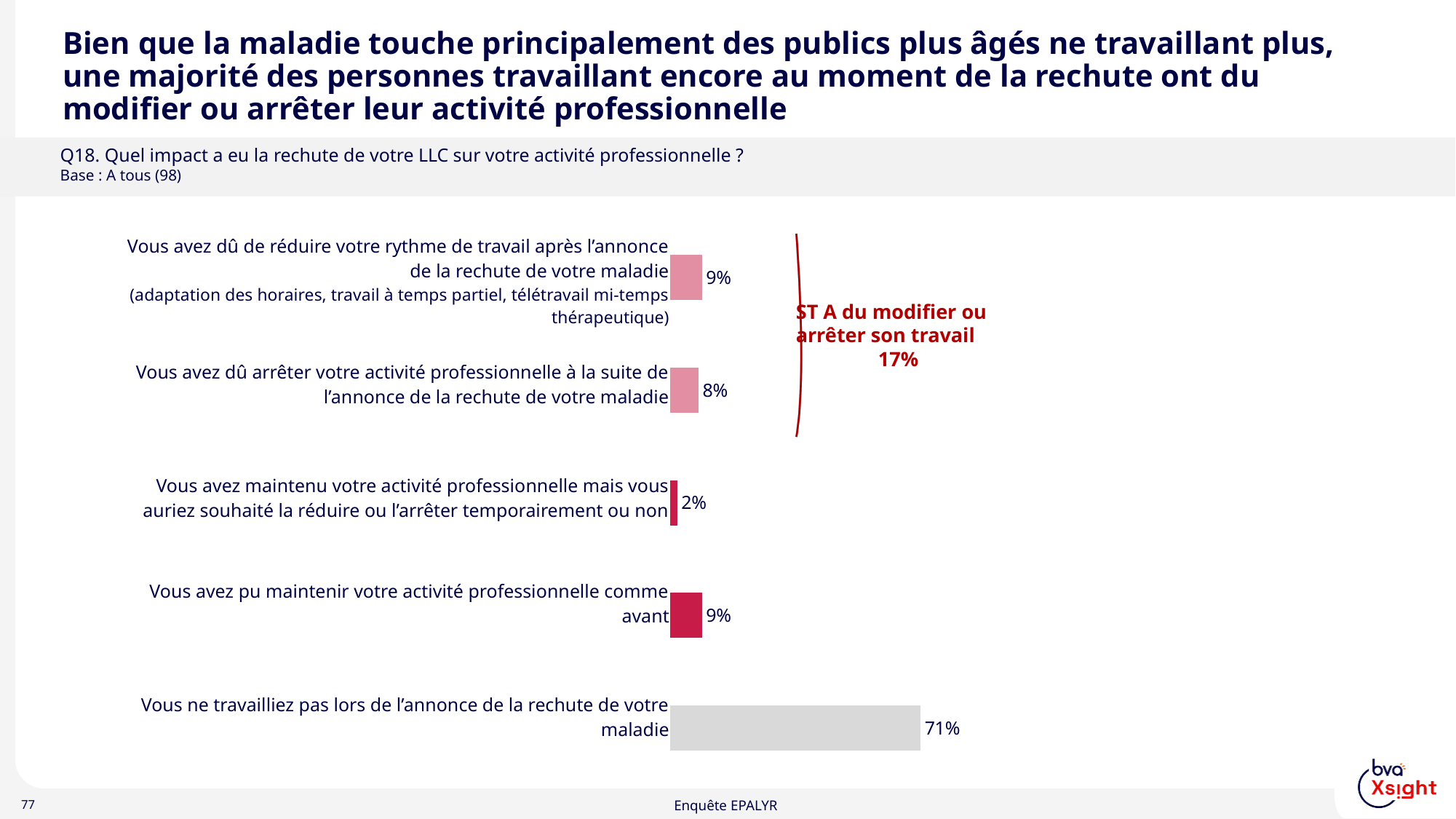
What percentage had to stop their professional activity following the relapse announcement? 8% How many categories are shown in the chart? 5 What percentage maintained their professional activity but would have liked to reduce or stop it temporarily or not? 2% What is the difference between the share who did not work at the time of the relapse (71%) and the share who were able to maintain their activity as before (9%)? 62 percentage points Which category has the lowest value? Vous avez maintenu votre activité professionnelle mais vous auriez souhaité la réduire ou l'arrêter temporairement ou non Which is larger: the share who had to reduce their work rhythm or the share who had to stop their professional activity? The share who had to reduce their work rhythm (9%) Which category has the highest value? Vous ne travailliez pas lors de l'annonce de la rechute de votre maladie What percentage were able to maintain their professional activity as before? 9% What type of chart is shown on the slide? Bar chart What percentage had to reduce their work rhythm after the relapse announcement? 9% What percentage of respondents did not work at the time of the relapse announcement ("Vous ne travailliez pas lors de l'annonce de la rechute de votre maladie")? 71% What is the value of the subtotal "ST A du modifier ou arrêter son travail" shown in red next to the chart? 17%